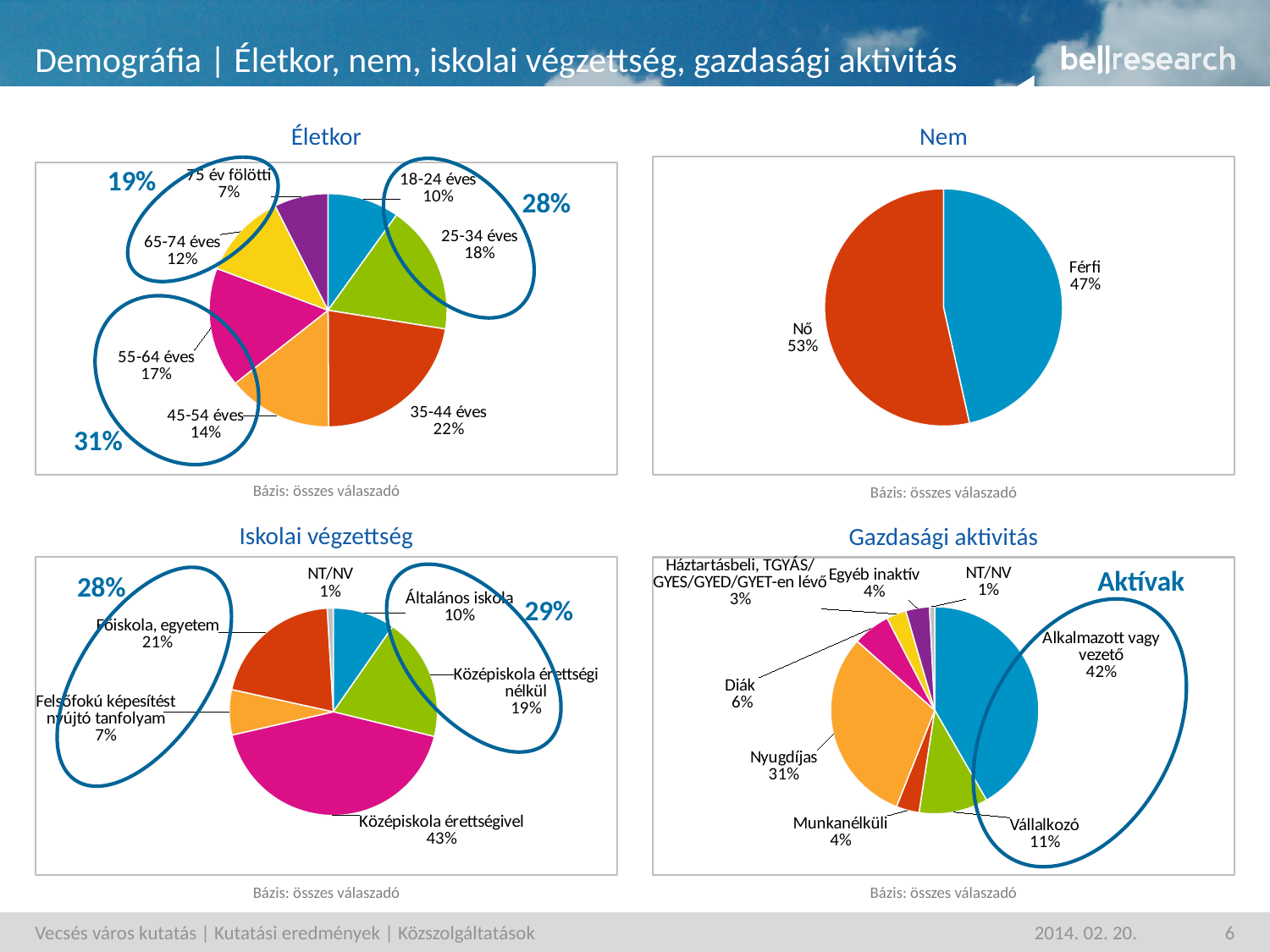
In the Gazdasági aktivitás chart, what is the difference between Alkalmazott vagy vezető and Vállalkozó? 31 percentage points In the Életkor chart, what is the difference between the 25-34 éves and 18-24 éves shares? 8 percentage points In the Gazdasági aktivitás chart, how many categories are shown? 8 What type of chart is the Nem chart? Pie chart In the Életkor chart, how many age categories are shown? 7 In the Iskolai végzettség chart, which category has the largest share? Középiskola érettségivel In the Iskolai végzettség chart, what share is Főiskola, egyetem? 21% In the Nem chart, which is larger, Férfi or Nő? Nő In the Gazdasági aktivitás chart, what share of respondents are Nyugdíjas? 31% In the Életkor chart, which age group has the smallest share? 75 év fölötti In the Életkor chart, what share of respondents are 35-44 éves? 22% In the Nem chart, what share of respondents are Nő? 53%